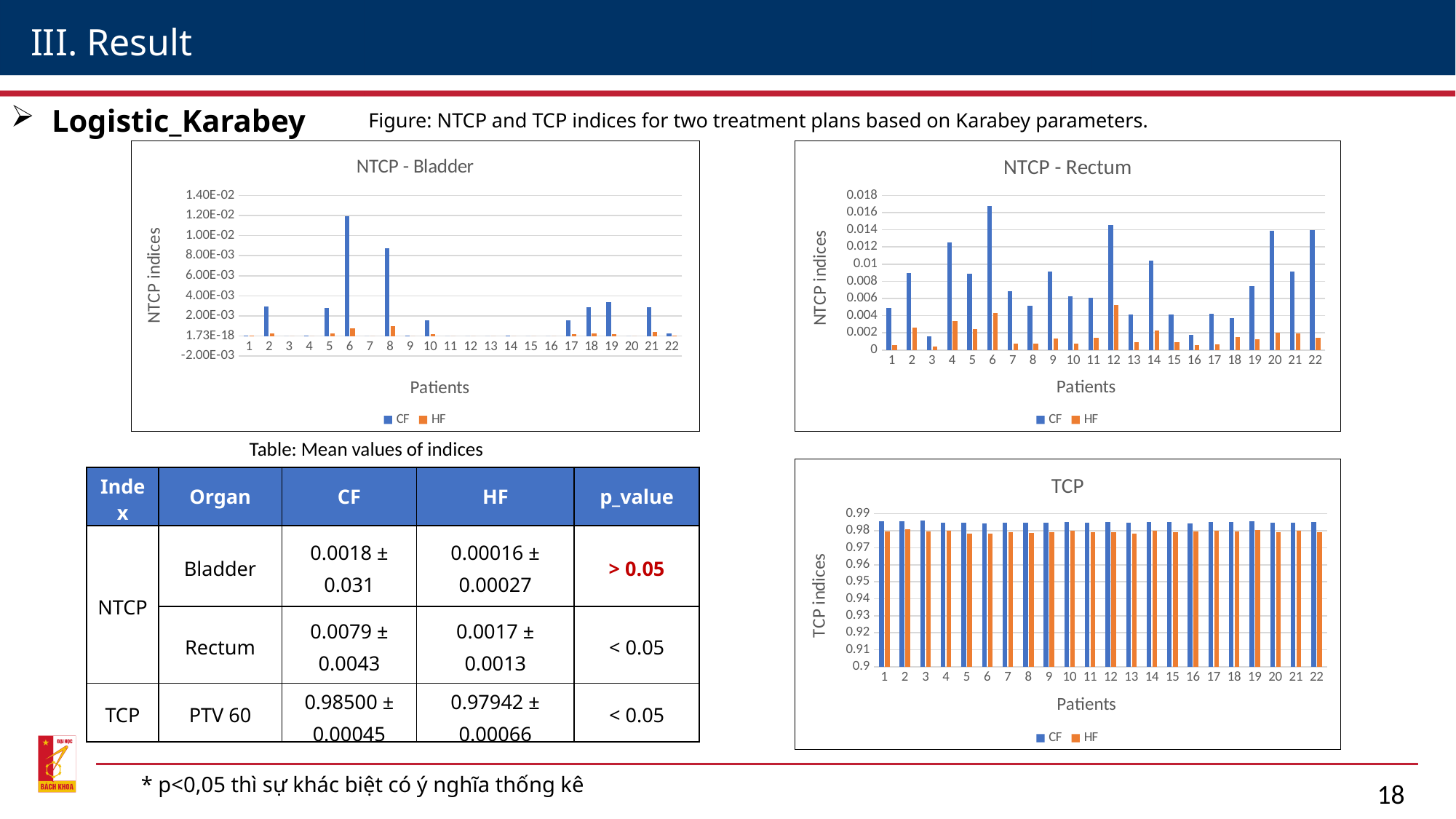
In the 'NTCP - Rectum' chart, which is larger for patient 20, the CF value or the HF value? CF In the 'TCP' chart, which is larger for patient 1, the CF value or the HF value? CF In the 'NTCP - Rectum' chart, is the HF value for patient 6 greater or less than 0.006? less In the 'NTCP - Bladder' chart, how many patients are shown on the x axis? 22 What kind of chart is the 'NTCP - Rectum' chart? bar chart What is the label of the y axis on the 'TCP' chart? TCP indices In the 'NTCP - Bladder' chart, which patient has the highest CF value? 6 In the 'TCP' chart, is the HF value for patient 10 greater or less than 0.97? greater In the 'NTCP - Rectum' chart, is the CF value for patient 12 greater or less than 0.012? greater In the 'NTCP - Rectum' chart, which patient has the highest CF value? 6 How many series does the legend of the 'TCP' chart list? 2